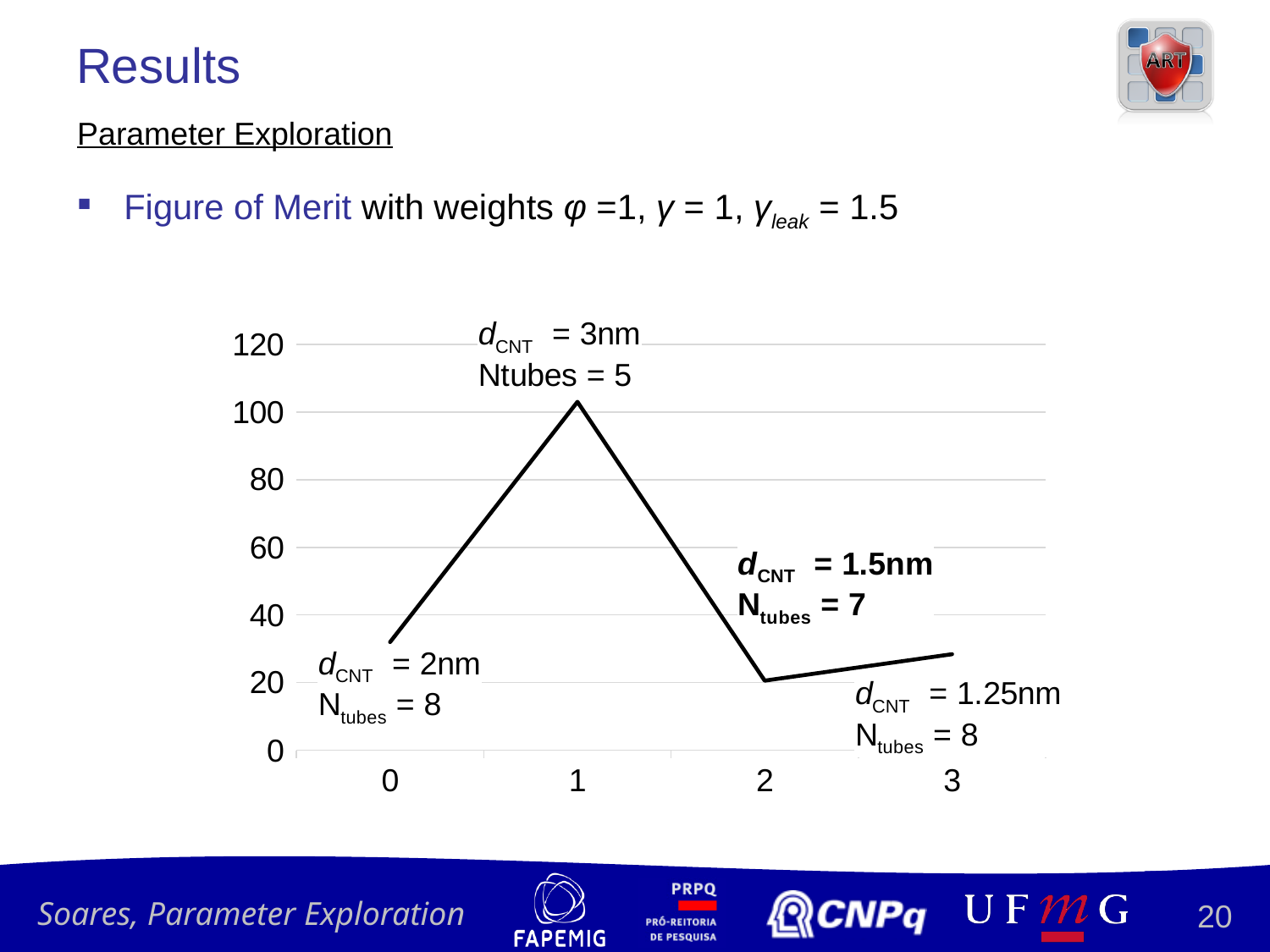
What d_CNT value is annotated at the peak of the line (x = 1)? 3nm Is the value at x = 2 greater or less than 40? less Is the value at x = 3 greater or less than 60? less Does the line rise or fall between x = 1 and x = 2? fall At which x-axis value does the line reach its highest point? 1 What N_tubes value is annotated for the point at x = 2? 7 Which has the larger value, the point at x = 0 or the point at x = 2? x = 0 Is the value at x = 0 greater or less than 20? greater How many data points are plotted on the line? 4 At which x-axis value does the line reach its lowest point? 2 What kind of chart is shown on the slide? line chart